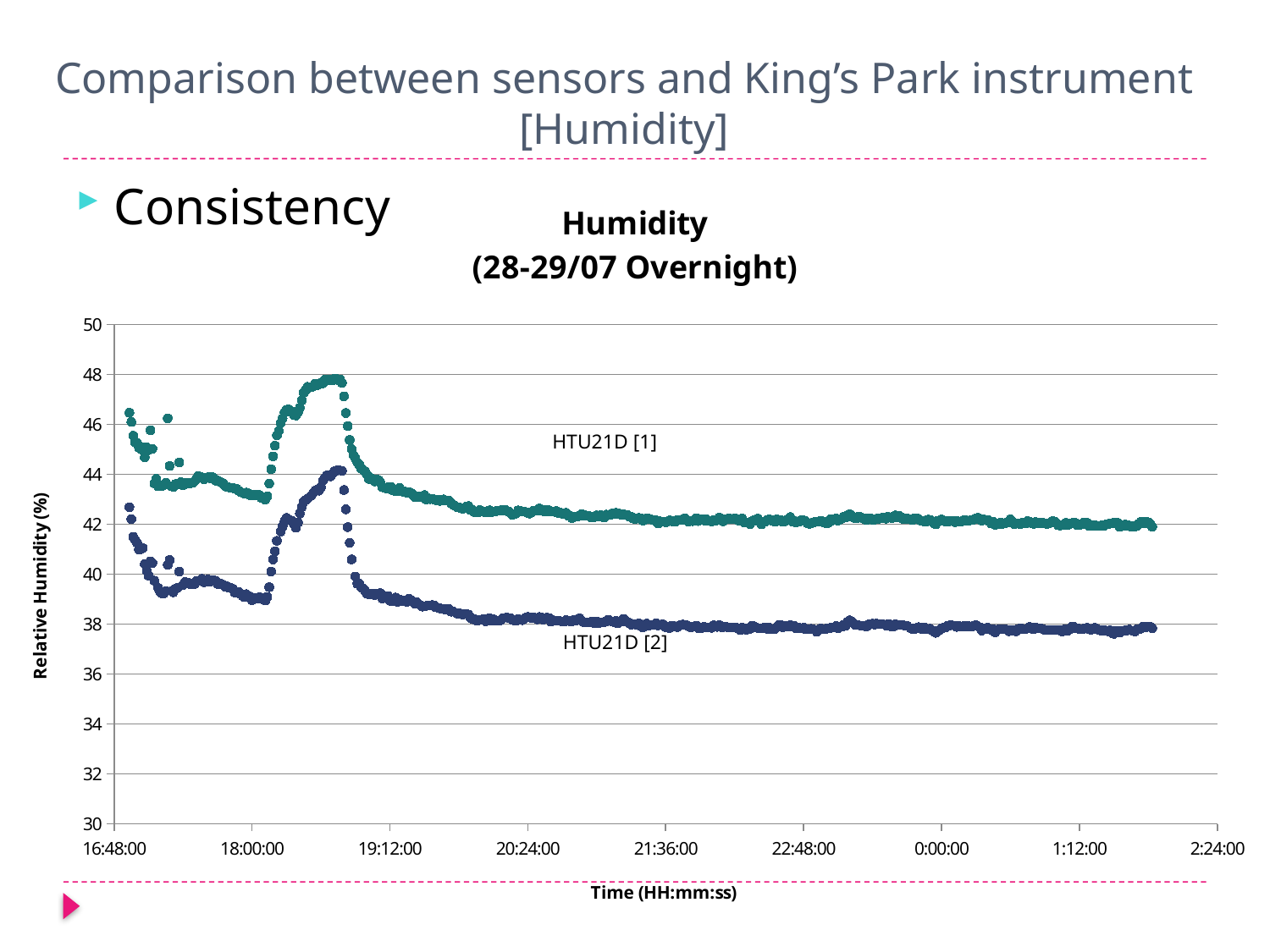
At 18:00:00, which series has the larger value, HTU21D [1] or HTU21D [2]? HTU21D [1] Which series has the higher relative humidity values throughout the chart, HTU21D [1] or HTU21D [2]? HTU21D [1] What is the title of the chart? Humidity (28-29/07 Overnight) What is the label of the vertical axis? Relative Humidity (%) Is the value for HTU21D [2] at 22:48:00 greater or less than 40? less Is the value for HTU21D [1] at 0:00:00 greater or less than 40? greater How many data series are plotted on the Humidity chart? 2 Is the peak value of HTU21D [1] greater or less than 46? greater What kind of chart is shown on the slide? scatter chart Do the values for HTU21D [1] rise or fall between 19:12:00 and 2:24:00? fall